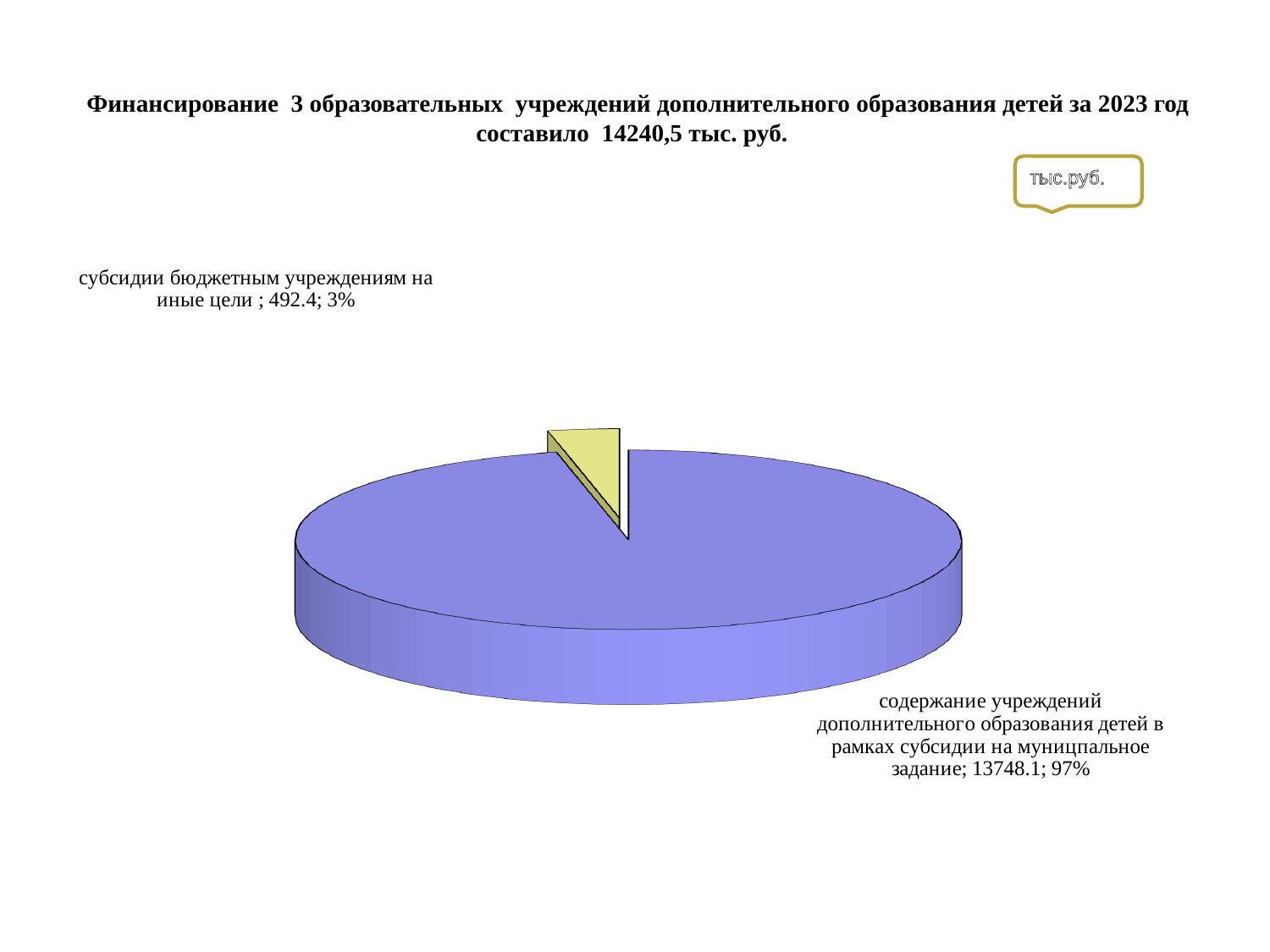
What share of the pie does "содержание учреждений дополнительного образования детей в рамках субсидии на муницпальное задание" represent? 97% What is the value for "субсидии бюджетным учреждениям на иные цели"? 492.4 Which is larger: the value for "субсидии бюджетным учреждениям на иные цели" or the value for "содержание учреждений дополнительного образования детей в рамках субсидии на муницпальное задание"? содержание учреждений дополнительного образования детей в рамках субсидии на муницпальное задание Which category has the largest slice of the pie? содержание учреждений дополнительного образования детей в рамках субсидии на муницпальное задание What colour is the slice for "субсидии бюджетным учреждениям на иные цели"? yellow What share of the pie does "субсидии бюджетным учреждениям на иные цели" represent? 3% What unit of measurement is indicated in the callout box on the slide? тыс.руб. What kind of chart is shown on the slide? pie chart What is the value for "содержание учреждений дополнительного образования детей в рамках субсидии на муницпальное задание"? 13748.1 Which category has the smallest slice of the pie? субсидии бюджетным учреждениям на иные цели What is the difference between the value for "содержание учреждений дополнительного образования детей в рамках субсидии на муницпальное задание" and the value for "субсидии бюджетным учреждениям на иные цели"? 13255.7 How many slices does the pie chart have? 2